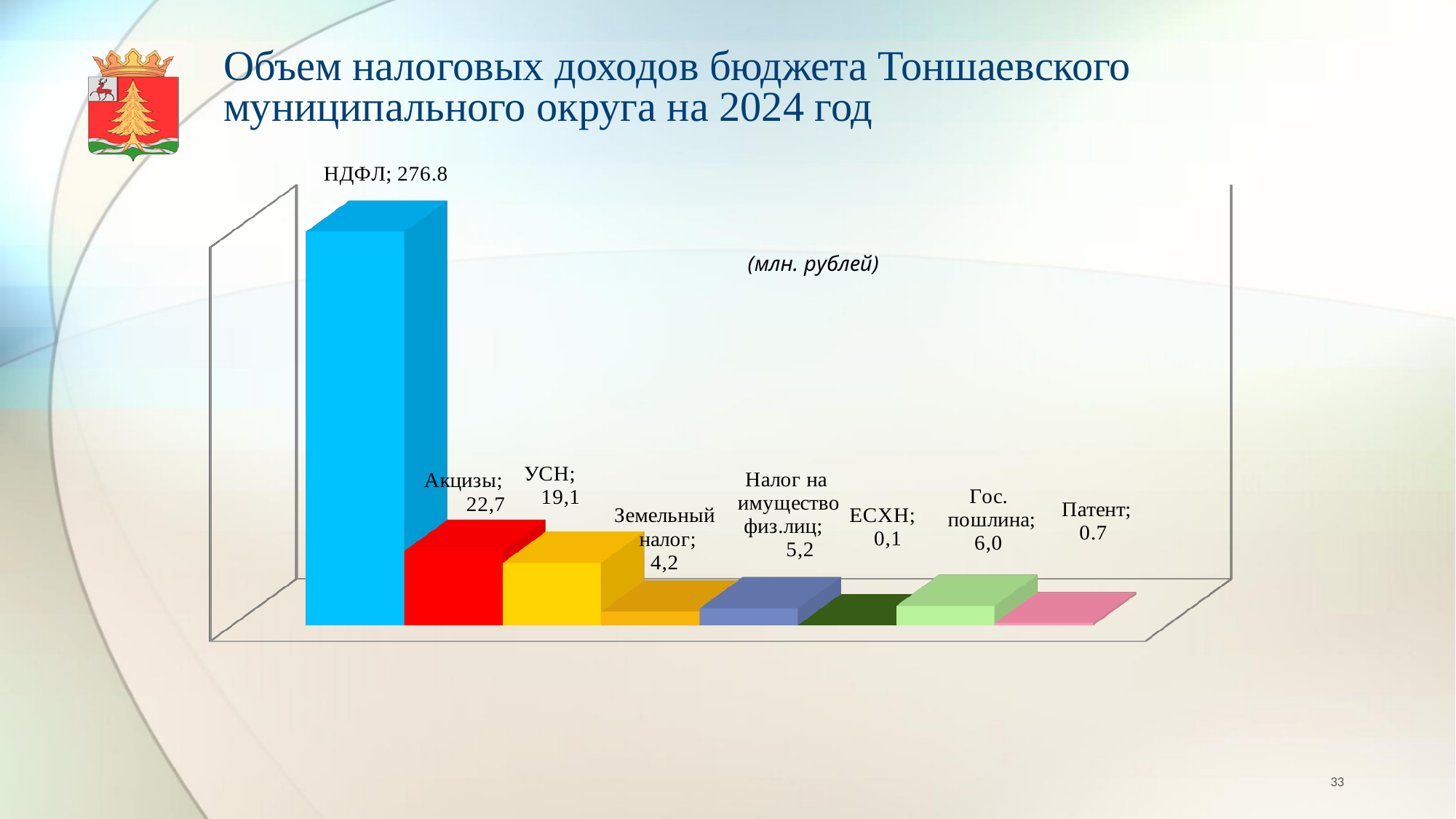
What is the value for Гос. пошлина? 6,0 Which is larger, the value for Гос. пошлина or the value for Налог на имущество физ.лиц? Гос. пошлина What is the difference between the values for Акцизы and УСН? 3,6 What is the value for НДФЛ? 276.8 What is the value for УСН? 19,1 Which category has the highest value? НДФЛ What is the value for Акцизы? 22,7 What is the value for Налог на имущество физ.лиц? 5,2 What kind of chart is shown on the slide? Bar chart Which category has the lowest value? ЕСХН How many categories are shown in the chart? 8 In what units are the values on the chart given? млн. рублей